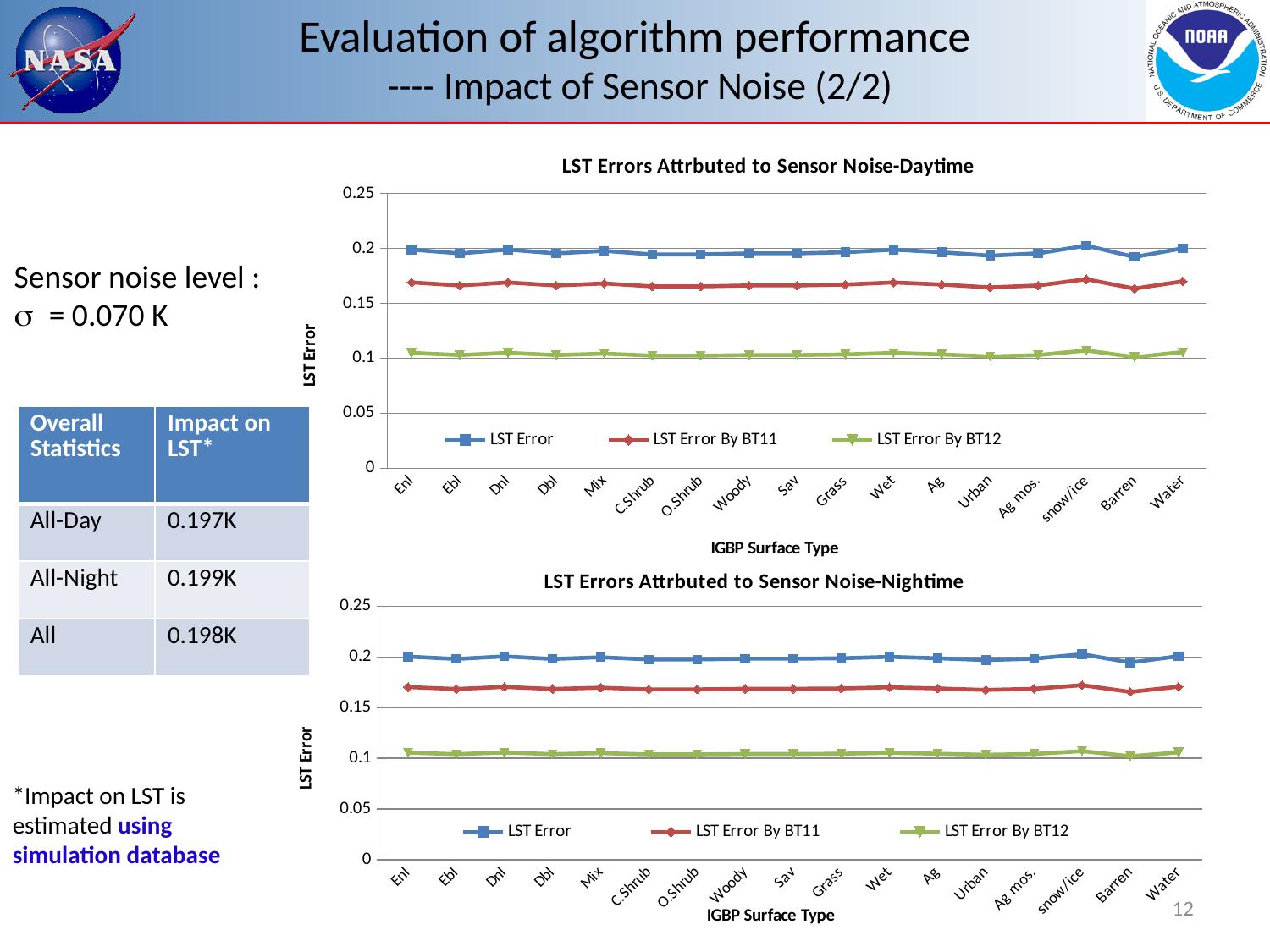
In the 'LST Errors Attrbuted to Sensor Noise-Daytime' chart, which series has the larger value for Woody: LST Error or LST Error By BT12? LST Error In the 'LST Errors Attrbuted to Sensor Noise-Daytime' chart, which series is plotted lowest across all surface types? LST Error By BT12 In the 'LST Errors Attrbuted to Sensor Noise-Nightime' chart, is the value of LST Error By BT11 for Grass greater or less than 0.2? less In the 'LST Errors Attrbuted to Sensor Noise-Nightime' chart, is the value of LST Error By BT12 for Barren greater or less than 0.05? greater What kind of chart is the 'LST Errors Attrbuted to Sensor Noise-Daytime' chart? line chart In the 'LST Errors Attrbuted to Sensor Noise-Daytime' chart, is the value of LST Error for Enl greater or less than 0.15? greater In the 'LST Errors Attrbuted to Sensor Noise-Nightime' chart, which series has the larger value for Urban: LST Error By BT11 or LST Error By BT12? LST Error By BT11 What is the x-axis title of the 'LST Errors Attrbuted to Sensor Noise-Nightime' chart? IGBP Surface Type How many series does the legend of the 'LST Errors Attrbuted to Sensor Noise-Nightime' chart list? 3 How many IGBP surface type categories are plotted along the x axis of the 'LST Errors Attrbuted to Sensor Noise-Daytime' chart? 17